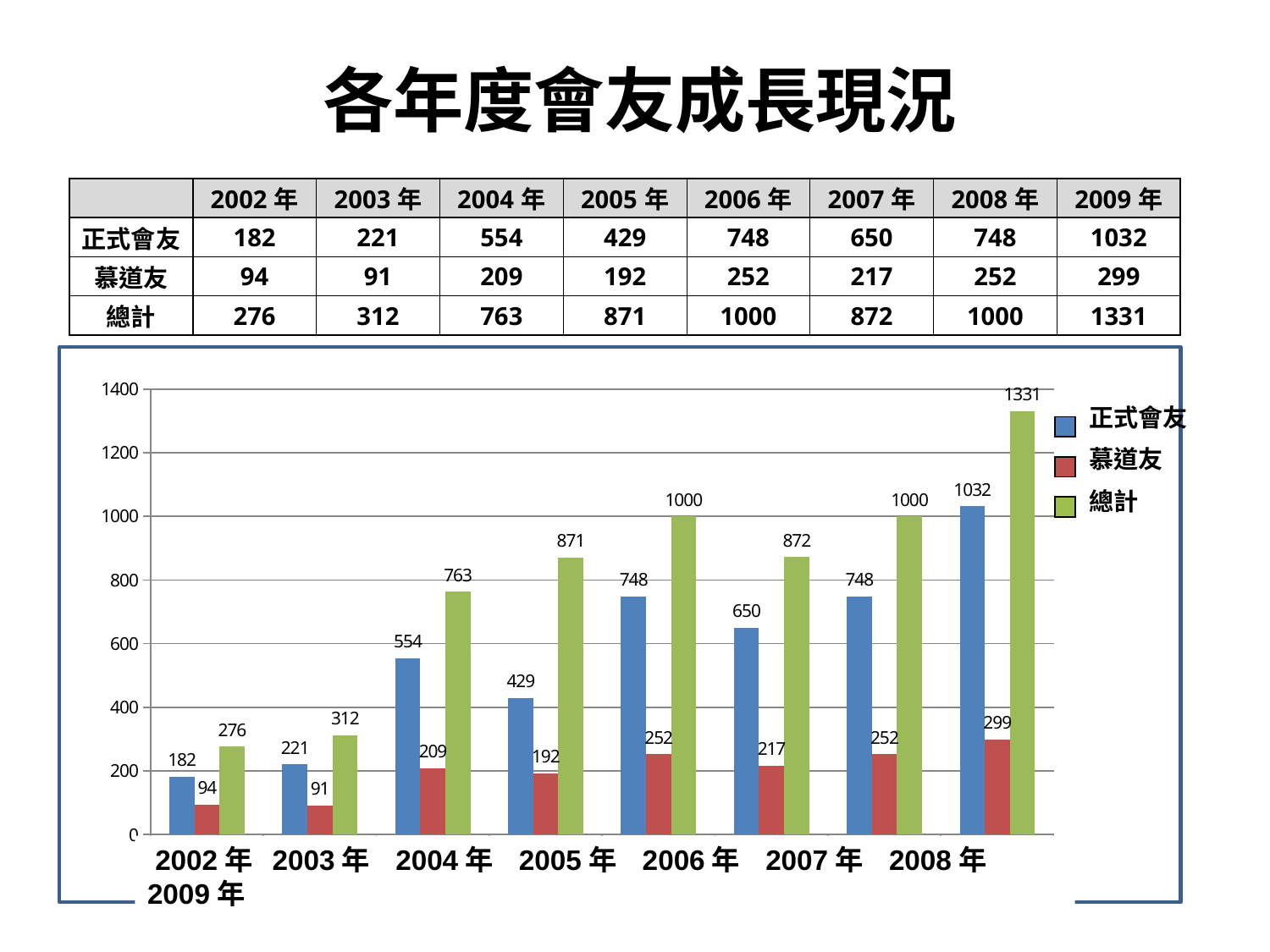
Which is larger, the 正式會友 value for 2005 年 or for 2004 年? 2004 年 Does the 總計 value generally rise or fall from 2002 年 to 2009 年? rise What type of chart is shown on the slide? bar chart Which year has the highest 總計 value? 2009 年 What is the value of 總計 for 2009 年? 1331 What is the difference between the 正式會友 values for 2009 年 and 2008 年? 284 What is the value of 慕道友 for 2006 年? 252 How many series does the chart legend list? 3 Which colour represents the 總計 series in the chart? green What is the value of 正式會友 for 2004 年? 554 Which year has the lowest 慕道友 value? 2003 年 How many years are plotted on the x axis of the chart? 8